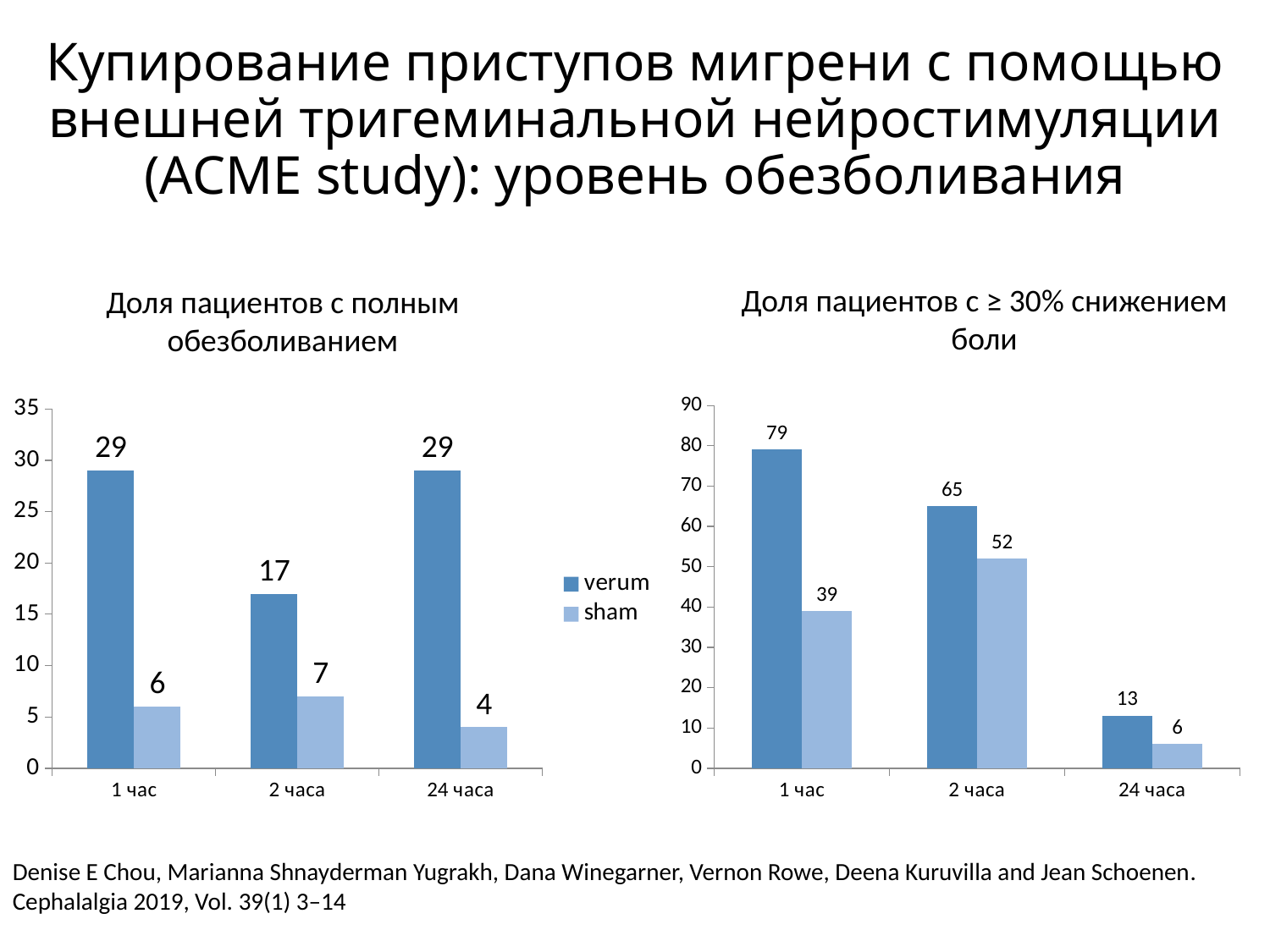
In the left chart (Доля пациентов с полным обезболиванием), what is the value for verum at 1 час? 29 In the right chart (Доля пациентов с ≥ 30% снижением боли), do the verum values rise or fall from 1 час to 24 часа? fall In the left chart (Доля пациентов с полным обезболиванием), which time point has the lowest sham value? 24 часа How many time-point categories does the left chart (Доля пациентов с полным обезболиванием) show? 3 In the left chart (Доля пациентов с полным обезболиванием), what is the difference between verum and sham at 24 часа? 25 In the right chart (Доля пациентов с ≥ 30% снижением боли), what is the value for sham at 24 часа? 6 In the right chart (Доля пациентов с ≥ 30% снижением боли), which time point has the highest verum value? 1 час In the right chart (Доля пациентов с ≥ 30% снижением боли), what is the value for verum at 2 часа? 65 In the right chart (Доля пациентов с ≥ 30% снижением боли), which is larger: sham at 2 часа or verum at 24 часа? sham at 2 часа In the right chart (Доля пациентов с ≥ 30% снижением боли), what is the difference between verum and sham at 1 час? 40 How many series does the legend list? 2 In the left chart (Доля пациентов с полным обезболиванием), what is the value for sham at 2 часа? 7